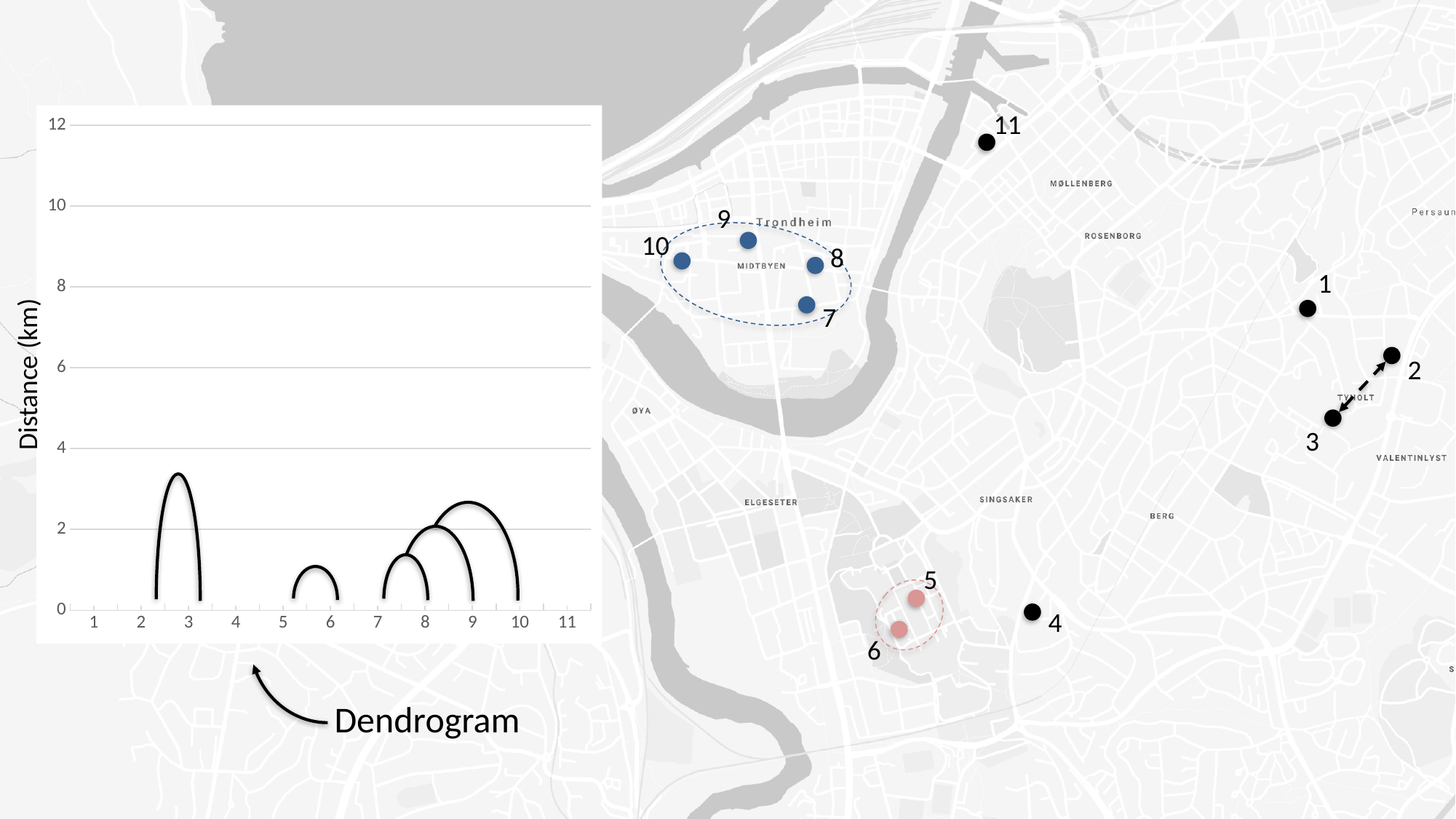
What kind of chart is shown on the slide? Dendrogram What is the label of the vertical axis of the dendrogram? Distance (km) Is the height of the top arc joining point 10 to the cluster of 7, 8 and 9 greater or less than 2? greater What is the highest tick value shown on the vertical axis of the dendrogram? 12 Is the height of the arc joining points 2 and 3 greater or less than 2? greater Is the height of the arc joining points 2 and 3 greater or less than 4? less Which is higher: the arc joining points 2 and 3, or the arc joining point 10 to the cluster of 7, 8 and 9? The arc joining 2 and 3 How many numbered points are listed along the x axis of the dendrogram? 11 How many arcs (merges) are drawn in the dendrogram? 5 Which pair of points is joined by the highest arc in the dendrogram? 2 and 3